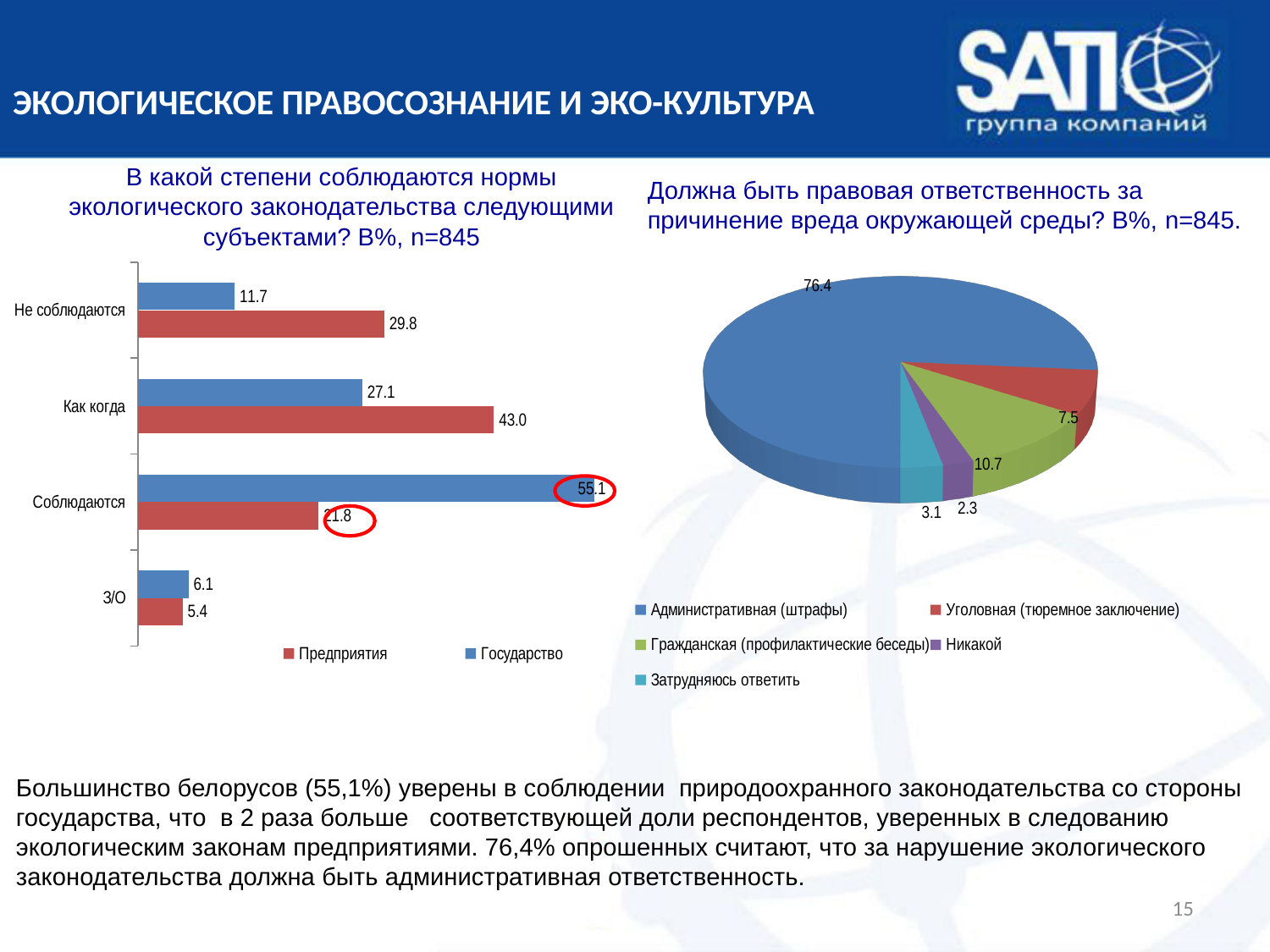
In the pie chart on the right, what is the difference between Гражданская (профилактические беседы) and Уголовная (тюремное заключение)? 3.2 In the left bar chart, what is the value for Предприятия in the category Как когда? 43.0 In the pie chart on the right, which slice is the smallest? Никакой In the left bar chart, which category has the highest value for the Предприятия series? Как когда In the left bar chart, what is the difference between the Государство and Предприятия values in the category Соблюдаются? 33.3 How many categories are shown in the left bar chart? 4 In the left bar chart, which is larger in the category Не соблюдаются: Предприятия or Государство? Предприятия In the left bar chart, what is the value for Государство in the category Соблюдаются? 55.1 In the pie chart on the right, what is the value for Административная (штрафы)? 76.4 In the left bar chart, which category has the lowest value for the Государство series? З/О What kind of chart is the chart on the left of the slide? bar chart How many series does the legend of the left bar chart list? 2